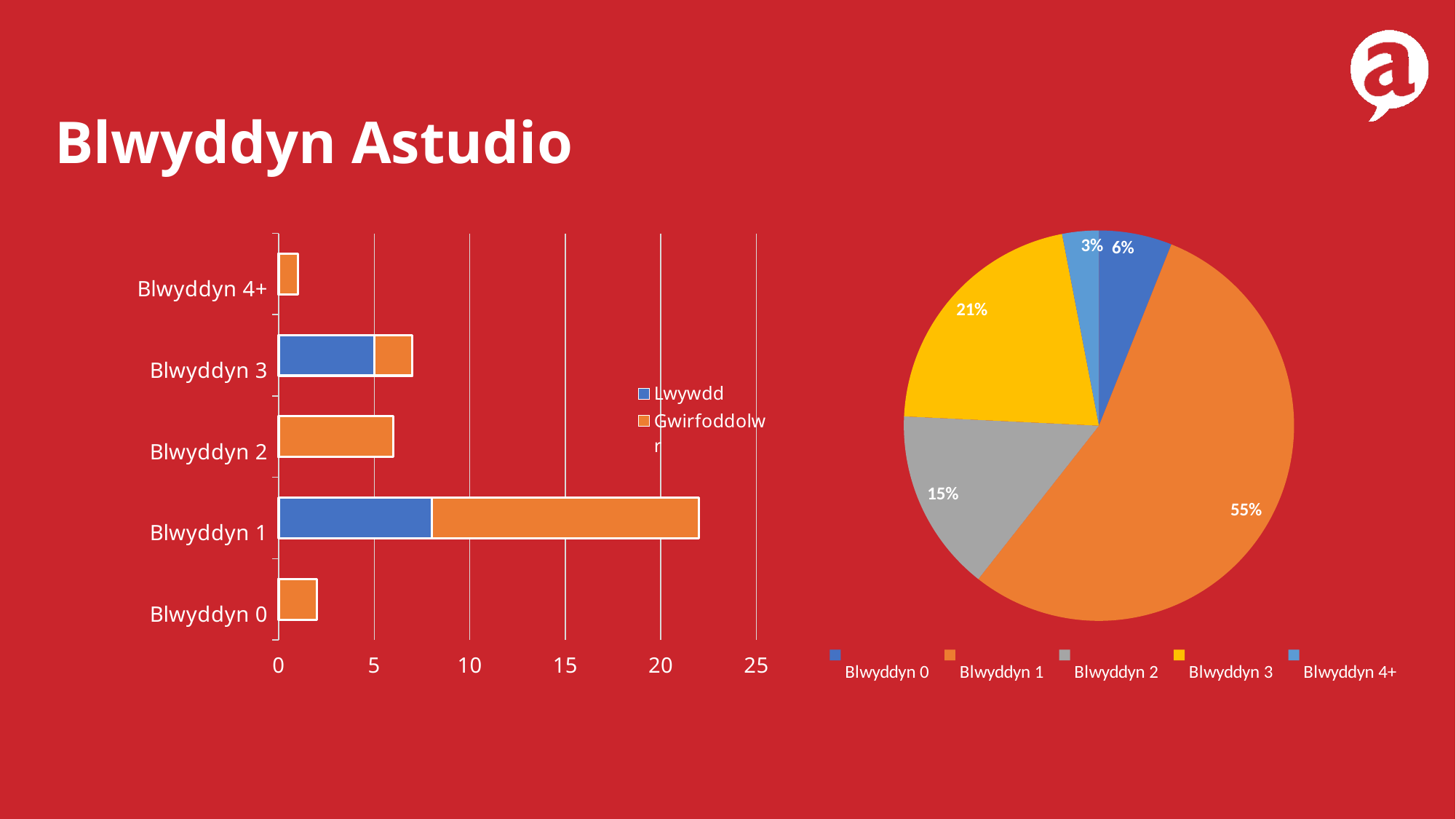
In the pie chart on the right, which category has the largest slice? Blwyddyn 1 In the pie chart on the right, what percentage is shown for Blwyddyn 3? 21% In the bar chart on the left, is the value for Blwyddyn 4+ greater or less than 5? less In the pie chart on the right, which slice is larger: Blwyddyn 0 or Blwyddyn 4+? Blwyddyn 0 In the pie chart on the right, how many slices does the pie have? 5 In the bar chart on the left, how many series does the legend list? 2 In the bar chart on the left, is the total length of the Blwyddyn 1 bar greater or less than 20? greater In the bar chart on the left, which category has the longest bar? Blwyddyn 1 What kind of chart is the chart on the left of the slide? Bar chart In the pie chart on the right, which category has the smallest slice? Blwyddyn 4+ In the pie chart on the right, how many percentage points larger is the Blwyddyn 3 slice than the Blwyddyn 2 slice? 6 percentage points In the pie chart on the right, what percentage is shown for Blwyddyn 1? 55%